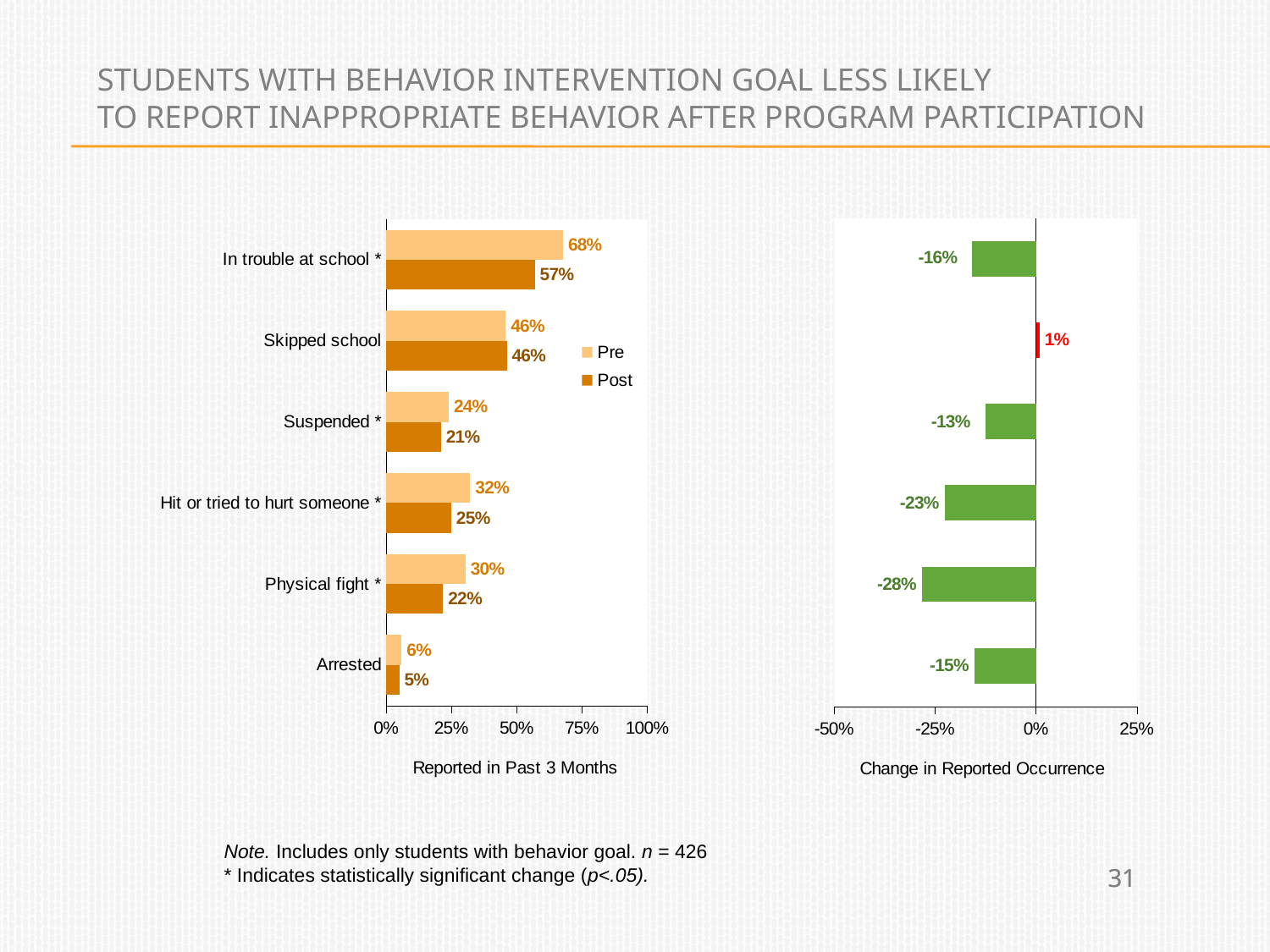
In the 'Reported in Past 3 Months' chart, how many categories are shown? 6 In the 'Reported in Past 3 Months' chart, which category has the lowest Post value? Arrested In the 'Reported in Past 3 Months' chart, what is the difference between the Pre and Post values for 'Hit or tried to hurt someone'? 7% In the 'Change in Reported Occurrence' chart, what is the largest decrease shown? -28% How many series does the legend of the 'Reported in Past 3 Months' chart list? 2 In the 'Reported in Past 3 Months' chart, is the Pre value for 'Suspended' larger or smaller than the Pre value for 'Physical fight'? smaller In the 'Reported in Past 3 Months' chart, which category has the highest Pre value? In trouble at school In the 'Change in Reported Occurrence' chart, what is the value of the bottom bar? -15% What kind of chart is the 'Change in Reported Occurrence' chart? bar chart In the 'Change in Reported Occurrence' chart, what is the value of the only positive (red) bar? 1% In the 'Reported in Past 3 Months' chart, what is the Post value for 'Physical fight'? 22% In the 'Reported in Past 3 Months' chart, what is the Pre value for 'In trouble at school'? 68%